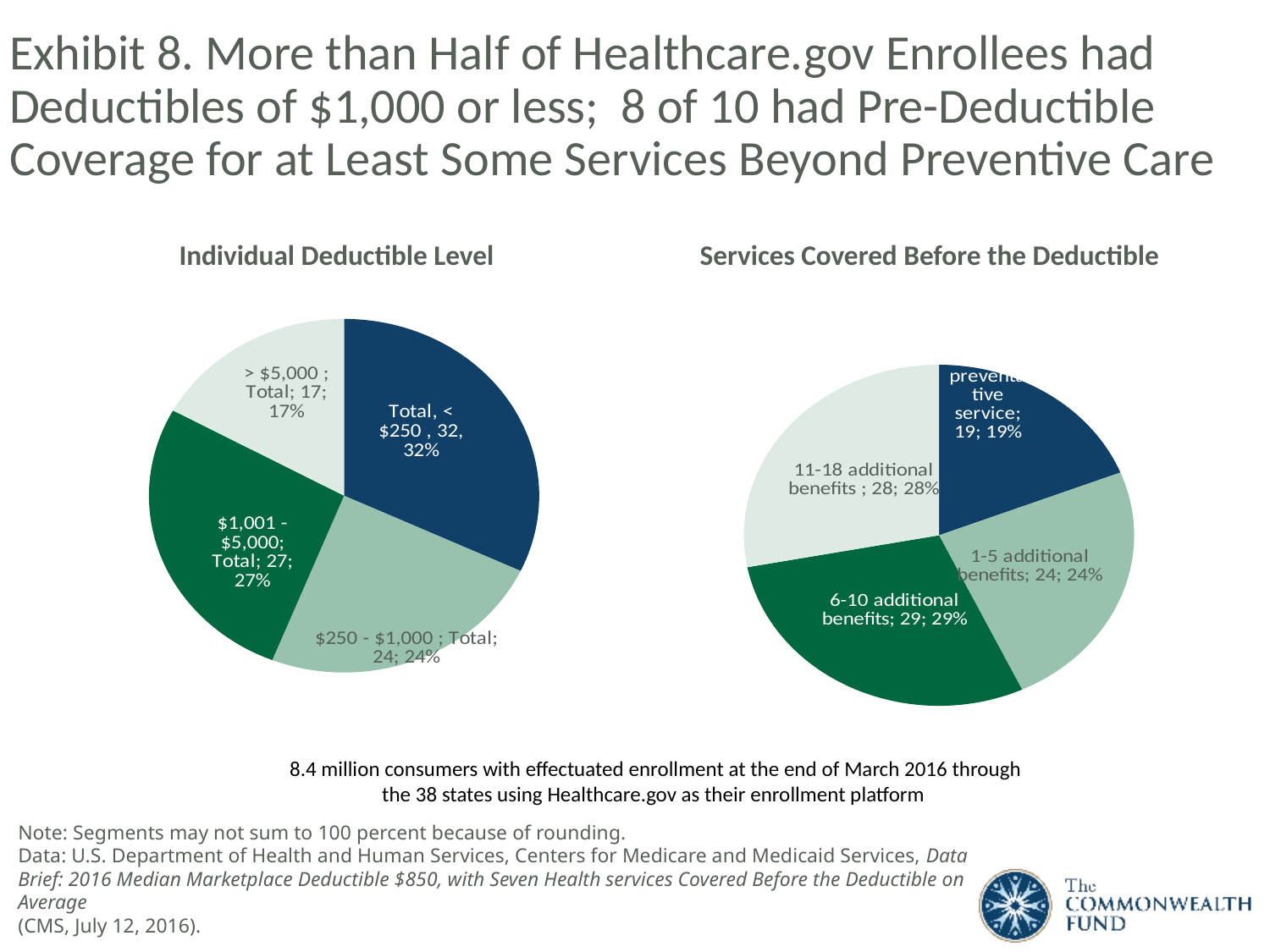
How many slices does the Individual Deductible Level pie chart have? 4 In the Individual Deductible Level pie chart, which deductible level has the smallest share? > $5,000 In the Services Covered Before the Deductible pie chart, what percentage of enrollees had 6-10 additional benefits covered? 29% In the Individual Deductible Level pie chart, what percentage of enrollees had a deductible of less than $250? 32% In the Services Covered Before the Deductible pie chart, which category has the smallest share? Preventive service In the Individual Deductible Level pie chart, what percentage of enrollees had a deductible greater than $5,000? 17% In the Individual Deductible Level pie chart, how many percentage points larger is the $1,001 - $5,000 slice than the $250 - $1,000 slice? 3 percentage points In the Services Covered Before the Deductible pie chart, what percentage of enrollees had 1-5 additional benefits covered? 24% What type of chart is used for Services Covered Before the Deductible? Pie chart How many slices does the Services Covered Before the Deductible pie chart have? 4 In the Individual Deductible Level pie chart, which deductible level has the largest share? < $250 In the Services Covered Before the Deductible pie chart, which is larger: 11-18 additional benefits or 1-5 additional benefits? 11-18 additional benefits